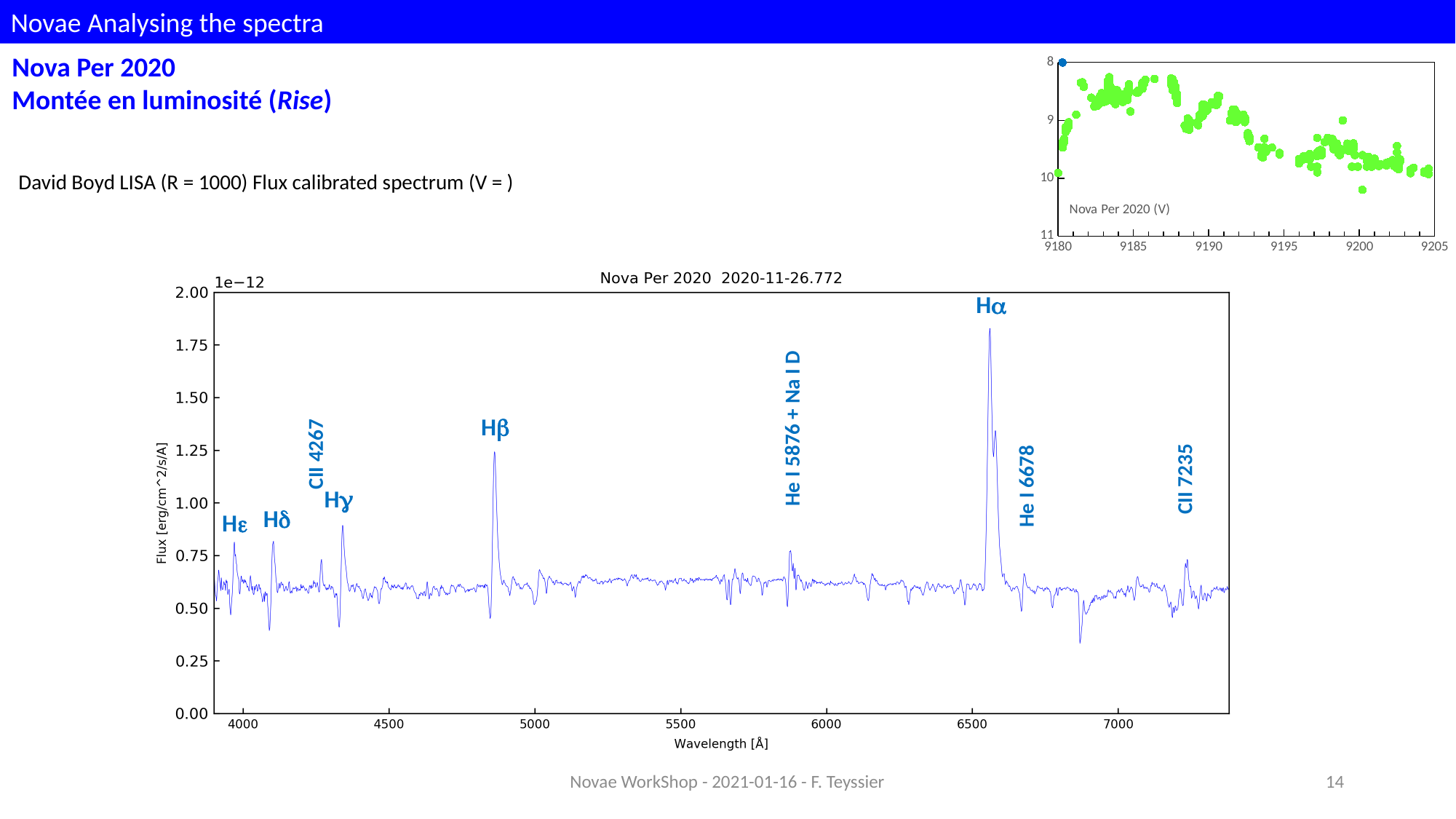
In the small top-right chart 'Nova Per 2020 (V)', what is the lowest value shown on the x axis? 9180 In the large spectrum chart, which line has a higher peak flux, Hβ or Hγ? Hβ In the large spectrum chart, which labelled emission line has the highest peak flux? Hα In the large spectrum chart, is the peak flux of the Hα line greater or less than 1.75 (×1e-12)? greater In the large spectrum chart, what is the label of the x axis? Wavelength [Å] In the large spectrum chart, which line has a higher peak flux, Hα or Hβ? Hα In the large spectrum chart, what is the label of the y axis? Flux [erg/cm^2/s/A] In the large spectrum chart, is the peak flux of the Hγ line greater or less than 1.00 (×1e-12)? less What kind of chart is the small chart in the top right labelled 'Nova Per 2020 (V)'? scatter chart What kind of chart is the large chart titled 'Nova Per 2020 2020-11-26.772'? line chart In the large spectrum chart, is the peak flux of the Hβ line greater or less than 1.00 (×1e-12)? greater How many labelled spectral lines are annotated on the large spectrum chart? 9